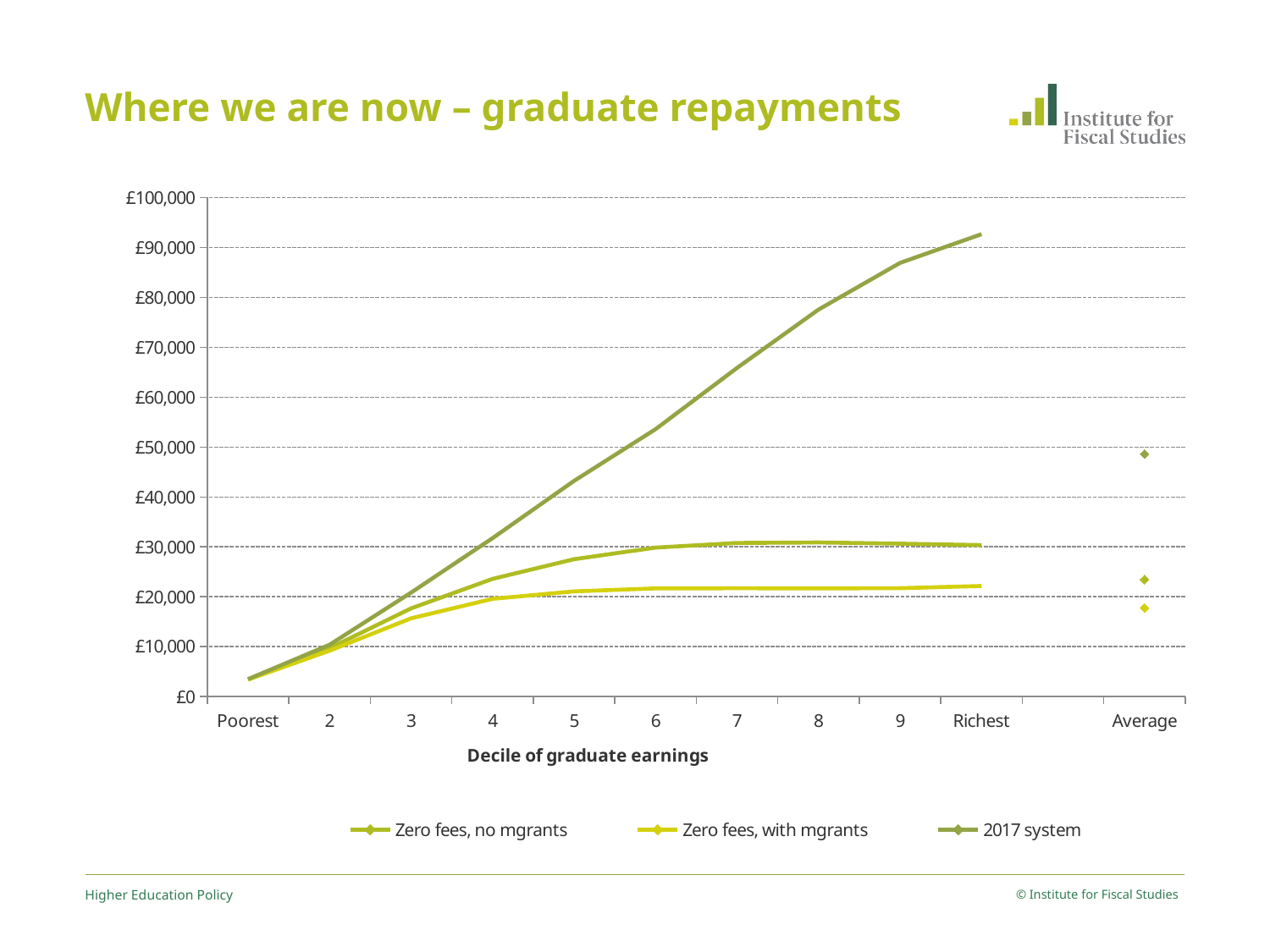
Is the value for Zero fees, with mgrants at the Richest decile greater or less than £30,000? less Is the Average value for the 2017 system greater or less than £40,000? greater Is the value for the 2017 system at the Richest decile greater or less than £80,000? greater How many series does the legend list? 3 At the Average point, which series has the lowest value? Zero fees, with mgrants How many category labels appear on the x axis? 11 At the Richest decile, which series has the highest value? 2017 system Does the 2017 system line rise or fall from the Poorest decile to the Richest decile? Rises What is the title of the x axis? Decile of graduate earnings What kind of chart is shown on the slide? Line chart